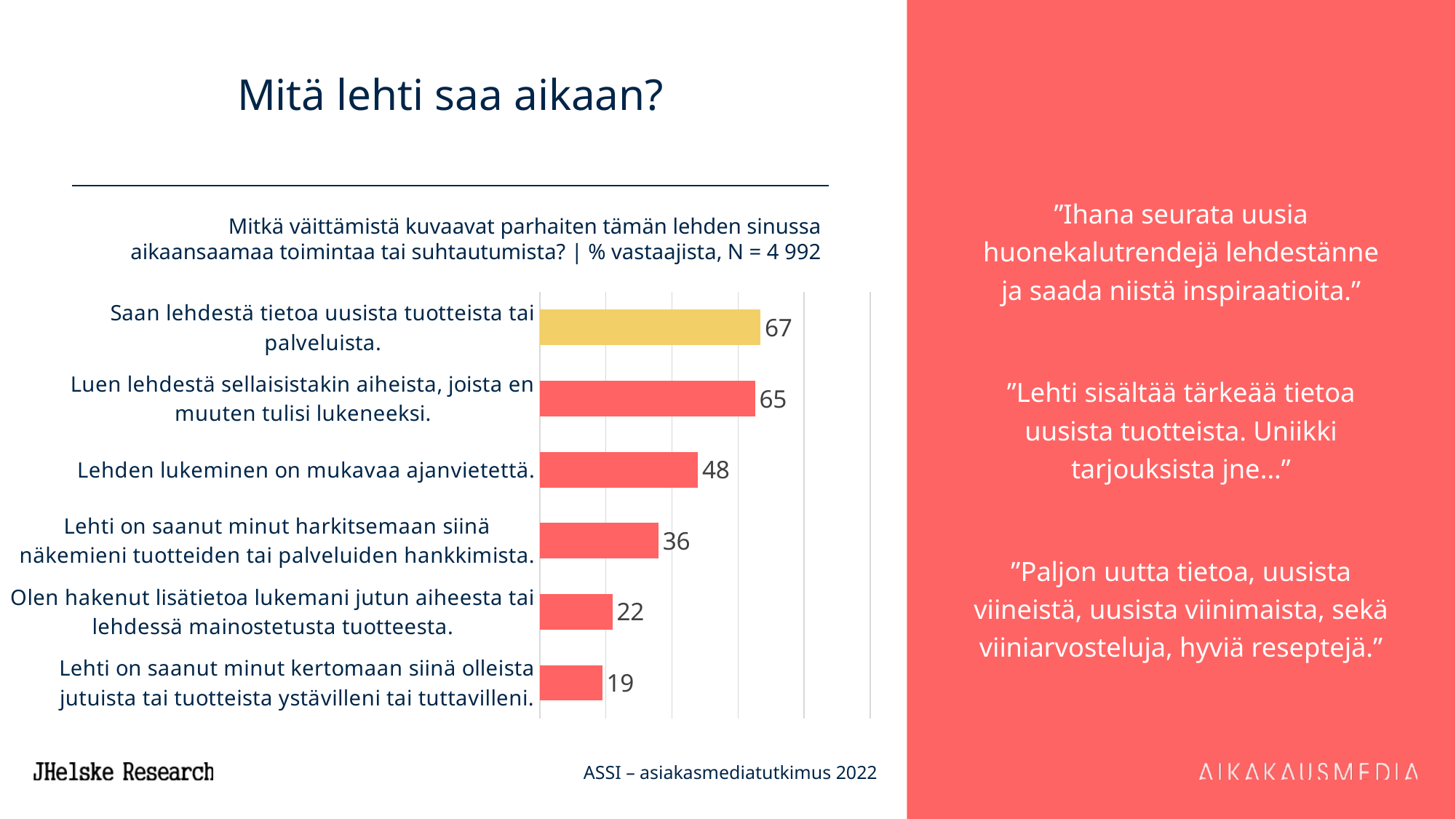
Which has a larger value: "Lehden lukeminen on mukavaa ajanvietettä." or "Lehti on saanut minut harkitsemaan siinä näkemieni tuotteiden tai palveluiden hankkimista."? Lehden lukeminen on mukavaa ajanvietettä. What is the difference between the values for "Lehden lukeminen on mukavaa ajanvietettä." and "Lehti on saanut minut kertomaan siinä olleista jutuista tai tuotteista ystävilleni tai tuttavilleni."? 29 Which bar is coloured differently (yellow) from the others? Saan lehdestä tietoa uusista tuotteista tai palveluista. What value is shown for "Lehti on saanut minut harkitsemaan siinä näkemieni tuotteiden tai palveluiden hankkimista."? 36 What kind of chart is shown on the slide? Bar chart What is the difference between the values for "Saan lehdestä tietoa uusista tuotteista tai palveluista." and "Luen lehdestä sellaisistakin aiheista, joista en muuten tulisi lukeneeksi."? 2 What value is shown for "Lehden lukeminen on mukavaa ajanvietettä."? 48 What is the number of respondents (N) stated in the chart subtitle? 4 992 Which statement has the highest value? Saan lehdestä tietoa uusista tuotteista tai palveluista. How many statements are shown in the chart? 6 Which statement has the lowest value? Lehti on saanut minut kertomaan siinä olleista jutuista tai tuotteista ystävilleni tai tuttavilleni. What value is shown for "Olen hakenut lisätietoa lukemani jutun aiheesta tai lehdessä mainostetusta tuotteesta."? 22